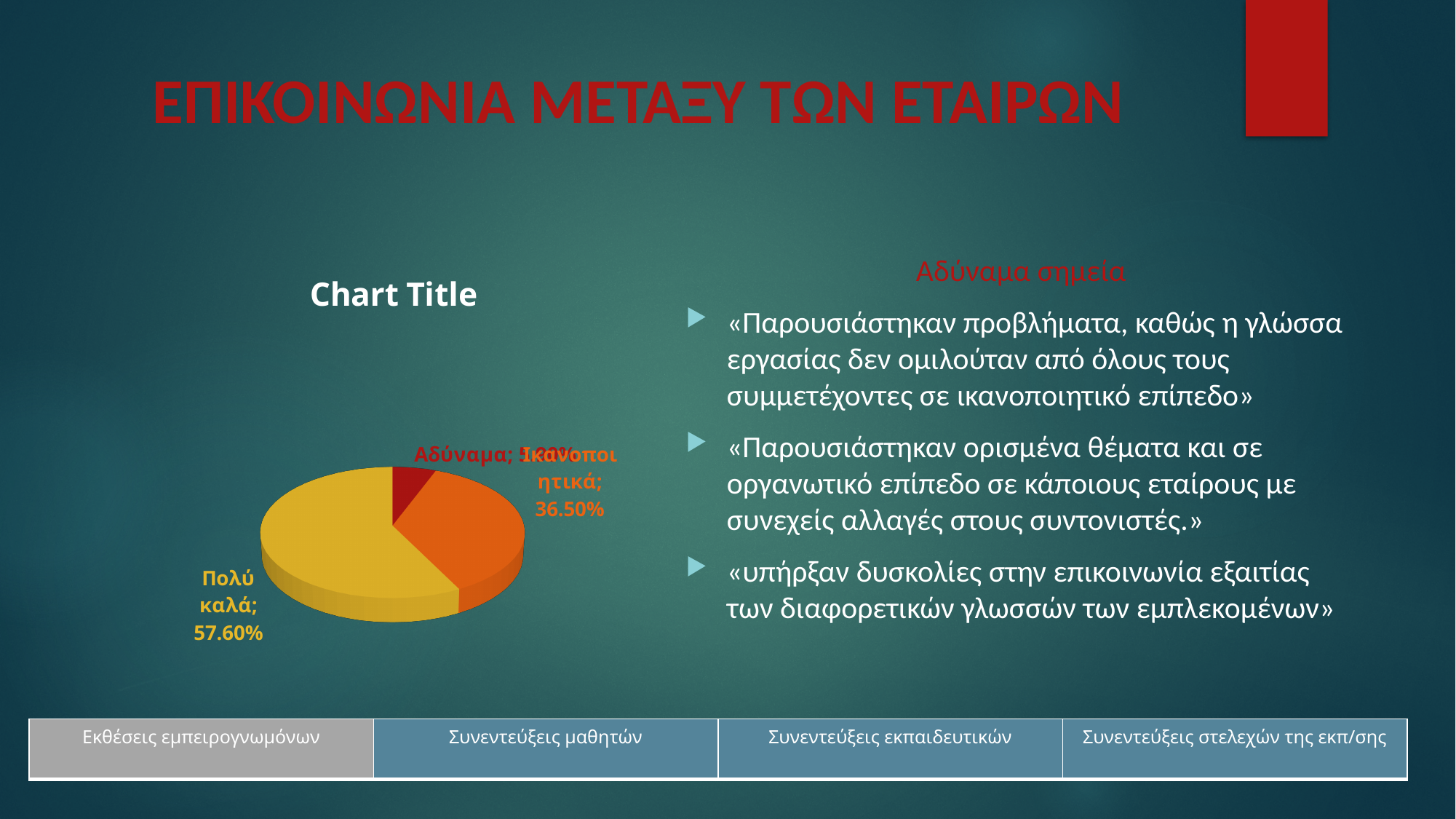
What colour is the Πολύ καλά slice? yellow What is the title of the chart? Chart Title What kind of chart is shown on the slide? pie chart How many slices does the pie chart have? 3 Which category has the smallest slice of the pie? Αδύναμα What is the difference in percentage points between the Πολύ καλά slice and the Ικανοποιητικά slice? 21.10% What share of the pie does the Ικανοποιητικά slice represent? 36.50% Which is larger, the Πολύ καλά slice or the Ικανοποιητικά slice? Πολύ καλά What percentage is shown for the Ικανοποιητικά slice? 36.50% Is the share for Πολύ καλά greater or less than 50%? greater What percentage is shown for the Πολύ καλά slice? 57.60% Which category has the largest slice of the pie? Πολύ καλά